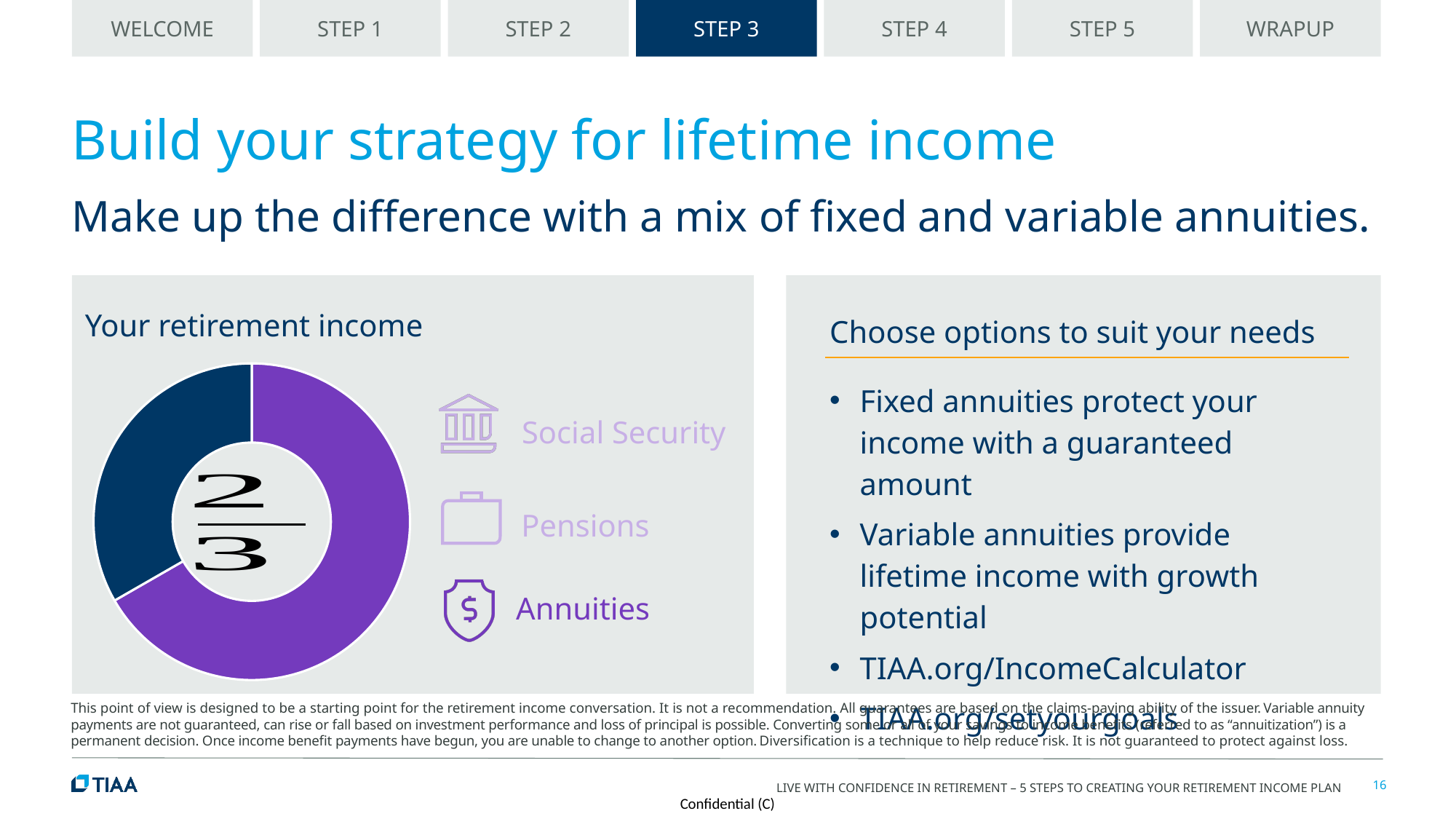
What kind of chart is shown under "Your retirement income"? Pie (donut) chart What is the title of the chart on the left of the slide? Your retirement income Which slice of the "Your retirement income" chart is the smallest? The dark navy slice In the "Your retirement income" chart, is the purple slice greater or less than half of the donut? greater Which legend entry of the "Your retirement income" chart is shown in the same purple colour as the large slice? Annuities In the "Your retirement income" chart, which slice is larger, the purple one or the dark navy one? The purple one In the "Your retirement income" chart, is the dark navy slice greater or less than half of the donut? less What fraction is printed in the center of the "Your retirement income" donut chart? 2/3 How many slices are visible in the "Your retirement income" donut chart? 2